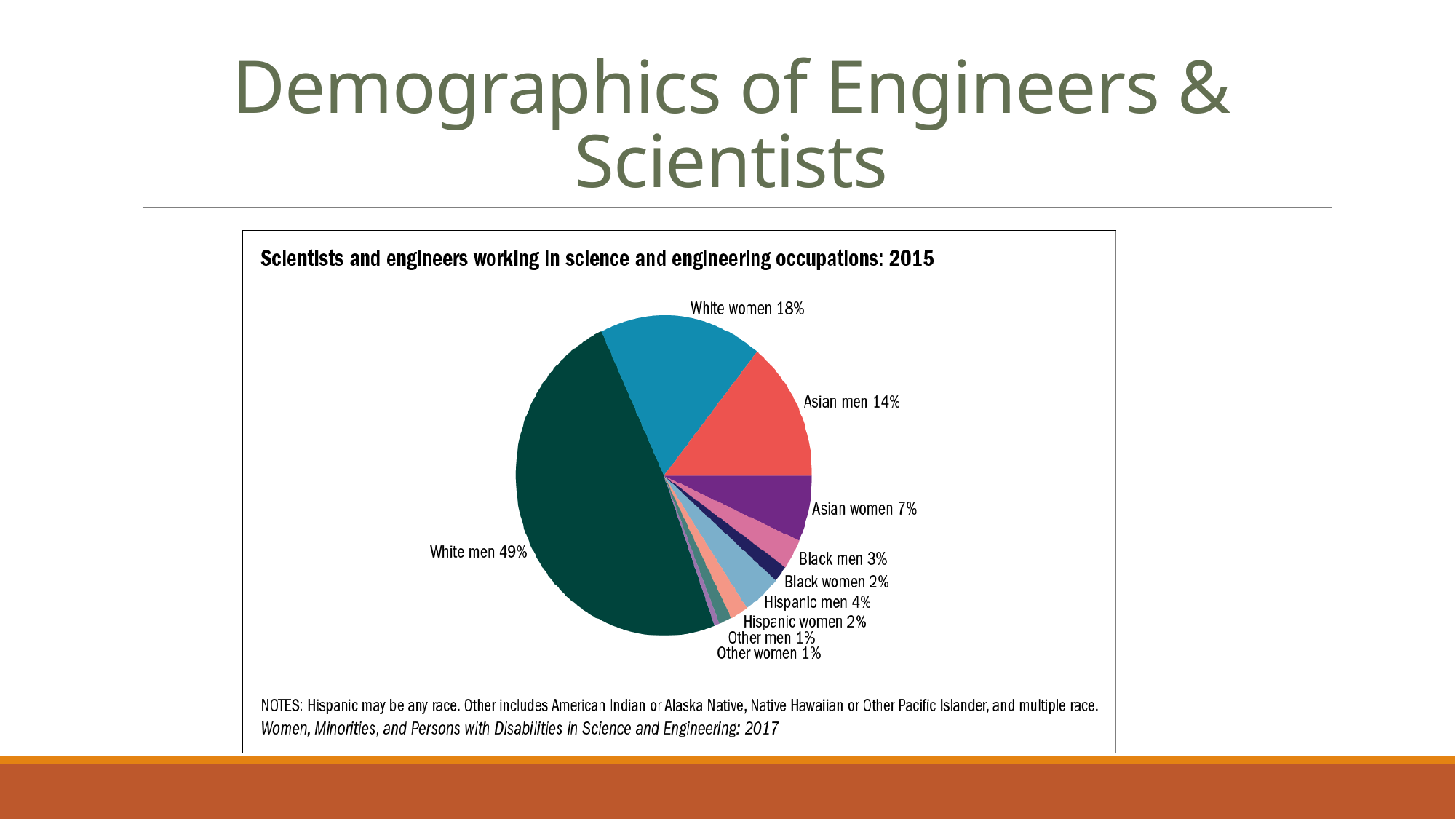
How many slices does the pie chart have? 10 What is the difference in percentage points between the White women and Asian men slices? 4 What is the combined share of Black men and Black women? 5% Which group has the largest slice of the pie? White men Which year does the chart's data refer to? 2015 What is the difference in percentage points between the Asian women and Black men slices? 4 What is the title of the chart? Scientists and engineers working in science and engineering occupations: 2015 What kind of chart is shown on the slide? Pie chart What percentage of the pie is labelled Asian men? 14% What share of scientists and engineers working in science and engineering occupations in 2015 are White men? 49% What share is shown for Hispanic men? 4% Which group has the larger share, White women or Asian women? White women